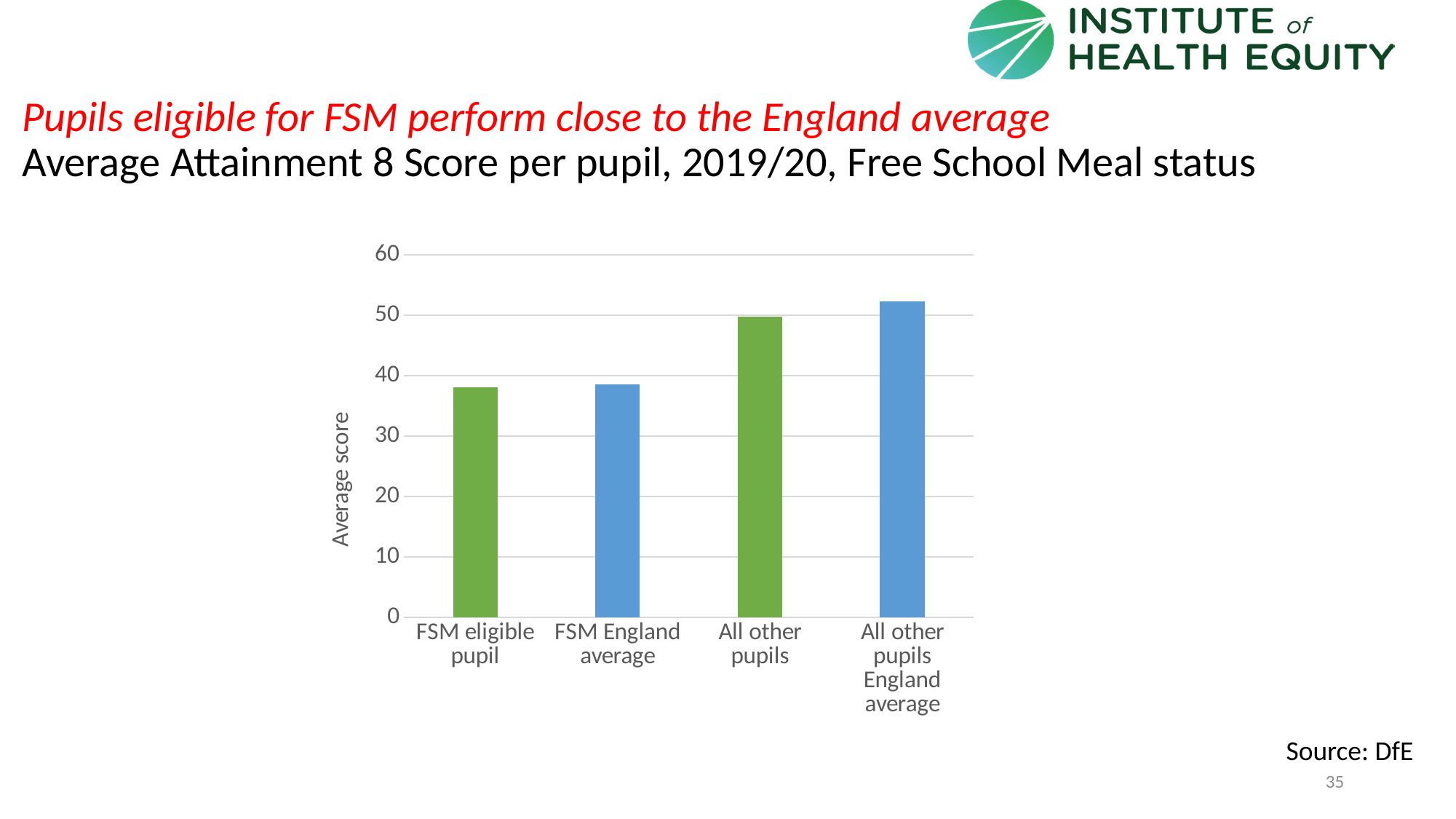
Which category has the highest average score? All other pupils England average What is the source of the data cited on the slide? DfE How many categories are plotted on the chart? 4 What is the label on the vertical axis of the chart? Average score Is the value for All other pupils greater or less than 40? greater Is the value for FSM England average greater or less than 40? less Do the values generally rise or fall from left to right across the categories? rise Which is larger, the value for All other pupils or the value for FSM eligible pupil? All other pupils What kind of chart is shown on the slide? bar chart Is the value for FSM eligible pupil greater or less than 40? less Which is larger, the value for FSM England average or the value for All other pupils England average? All other pupils England average